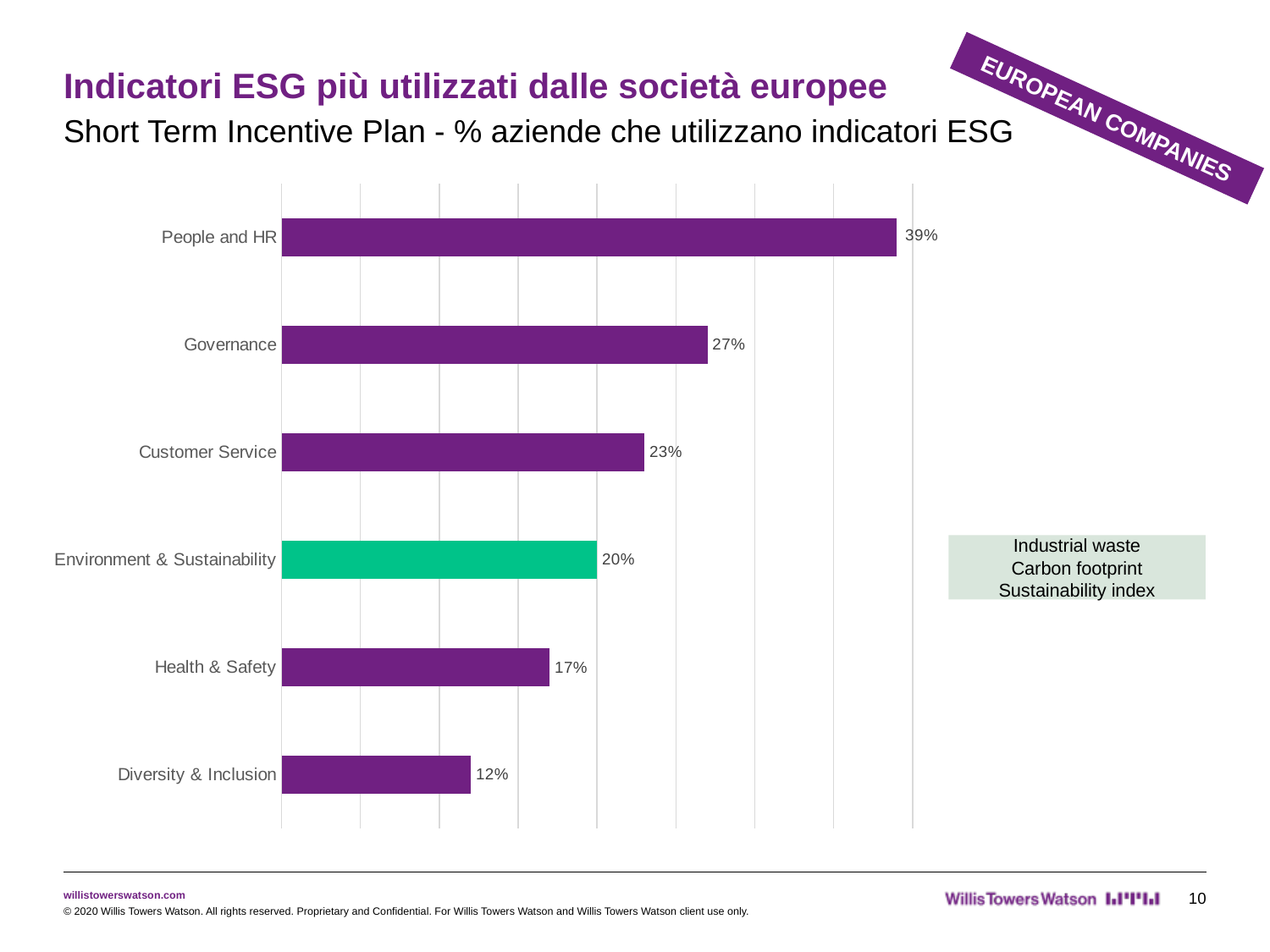
What is the difference between People and HR and Diversity & Inclusion? 27% Which ESG indicator category has the lowest percentage? Diversity & Inclusion How many ESG indicator categories are shown in the chart? 6 What percentage of companies use People and HR indicators in the Short Term Incentive Plan? 39% What is the value shown for Health & Safety? 17% Which is larger, the value for Governance or the value for Health & Safety? Governance What is the value shown for Environment & Sustainability? 20% What type of chart is shown on the slide? Bar chart Which bar is highlighted in a different colour (green) from the others? Environment & Sustainability What three examples are listed in the box next to the Environment & Sustainability bar? Industrial waste, Carbon footprint, Sustainability index What is the difference in percentage points between Governance and Customer Service? 4% Which ESG indicator category has the highest percentage? People and HR